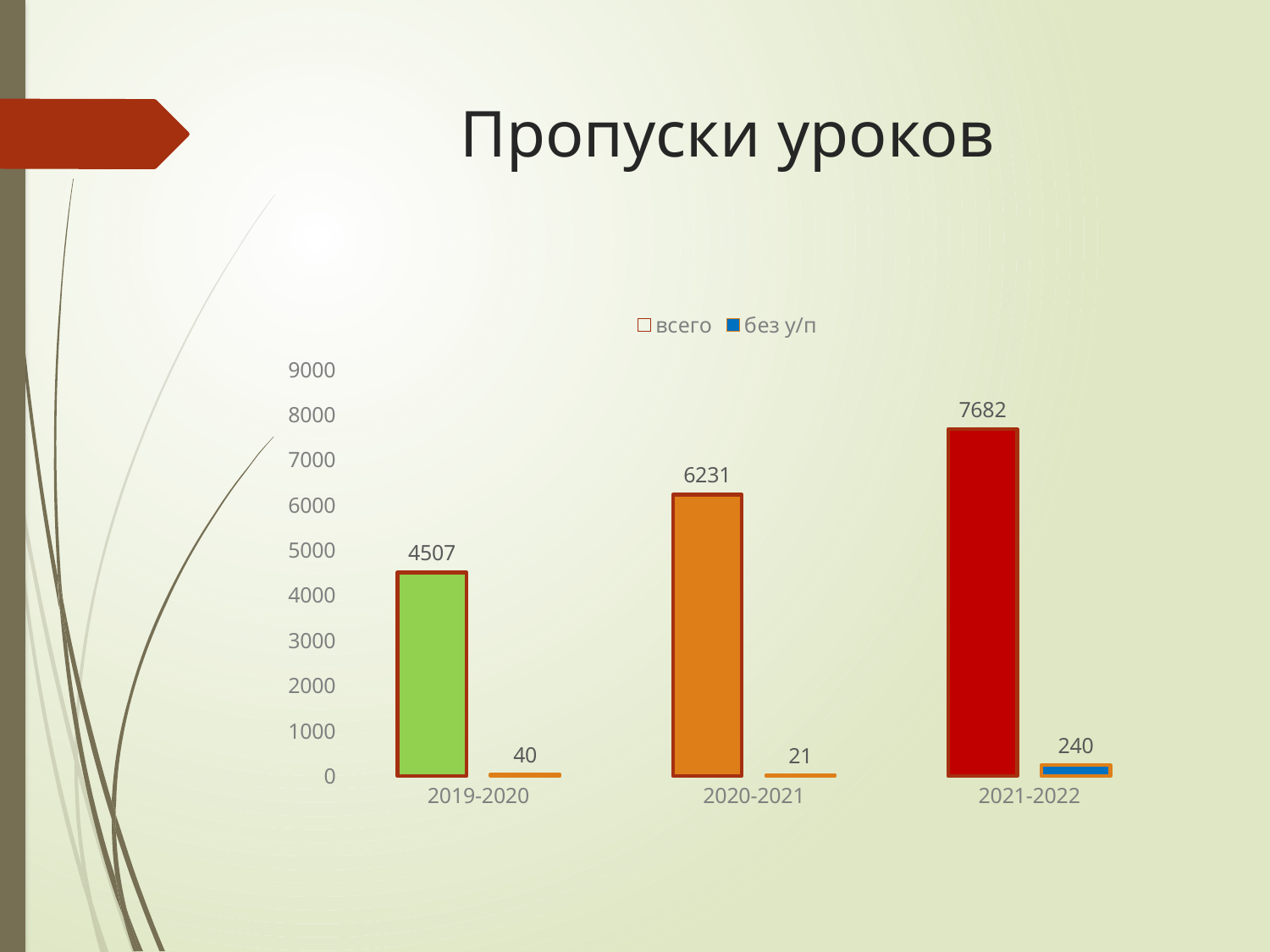
What is the difference between the "всего" values for 2021-2022 and 2019-2020? 3175 Which is larger: "без у/п" for 2019-2020 or for 2020-2021? 2019-2020 What is the value of "без у/п" for 2020-2021? 21 What is the value of "всего" for 2019-2020? 4507 Which year has the highest value for "всего"? 2021-2022 How many year categories are shown on the x axis? 3 Which year has the lowest value for "без у/п"? 2020-2021 Does the "всего" series rise or fall from 2019-2020 to 2021-2022? rise What is the value of "всего" for 2020-2021? 6231 What is the value of "без у/п" for 2021-2022? 240 How many series does the legend list? 2 Is the value of "всего" for 2020-2021 greater or less than 6000? greater